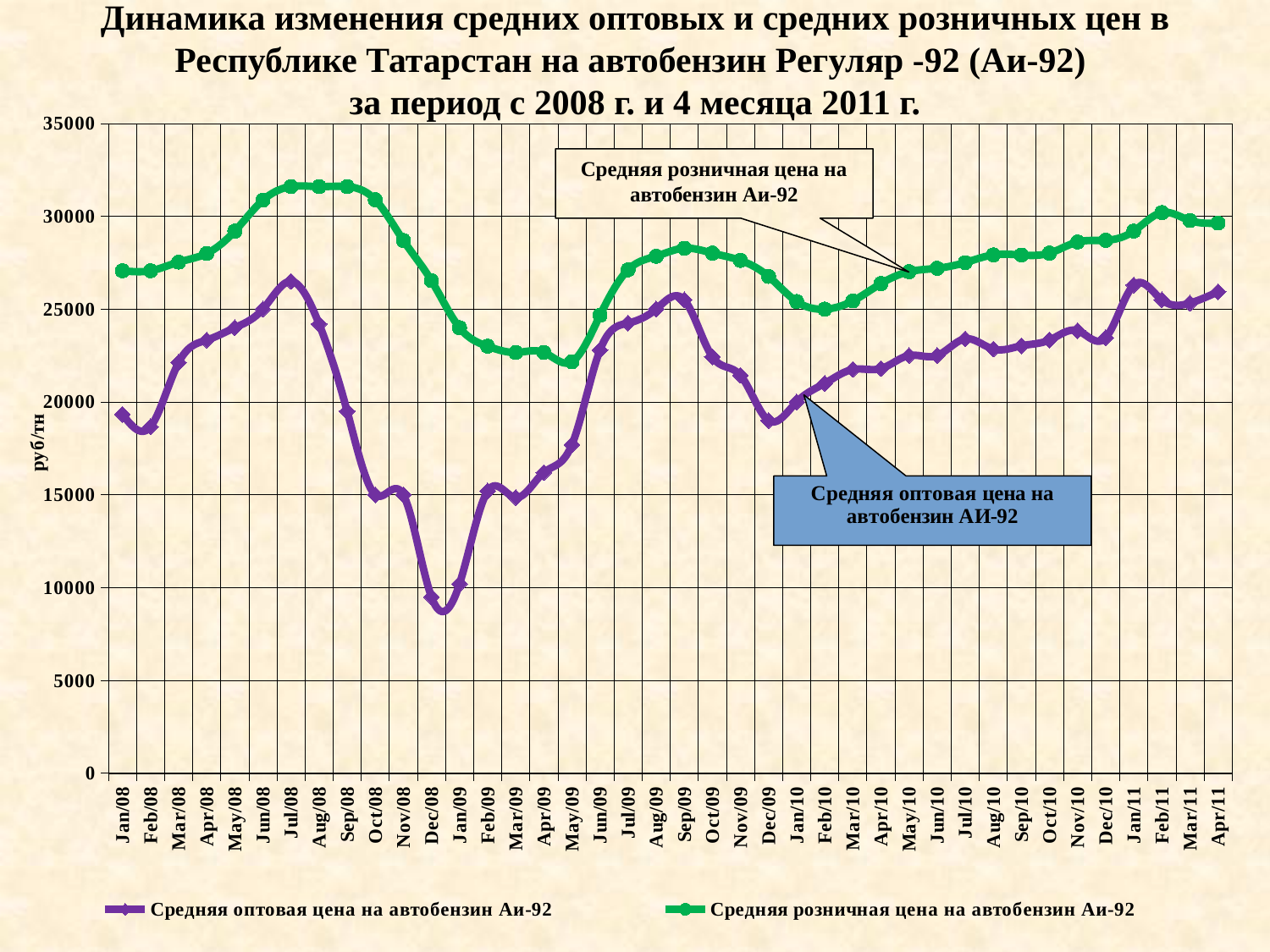
Is the value of the average retail price (Средняя розничная цена) in Jul/08 greater or less than 30000? greater Does the average retail price rise or fall from May/09 to Sep/09? rise What kind of chart is shown on the slide? line chart How many series does the legend list? 2 In which month is the average wholesale price (Средняя оптовая цена) at its lowest? Dec/08 How many monthly points are plotted along the x axis? 40 What is the label on the y axis? руб/тн Is the value of the average wholesale price (Средняя оптовая цена) in Jan/08 greater or less than 20000? less Which series has the higher value in Dec/08, the wholesale price or the retail price? Средняя розничная цена на автобензин Аи-92 Is the value of the average wholesale price (Средняя оптовая цена) in Dec/08 greater or less than 10000? less Does the average wholesale price rise or fall from Jul/08 to Dec/08? fall